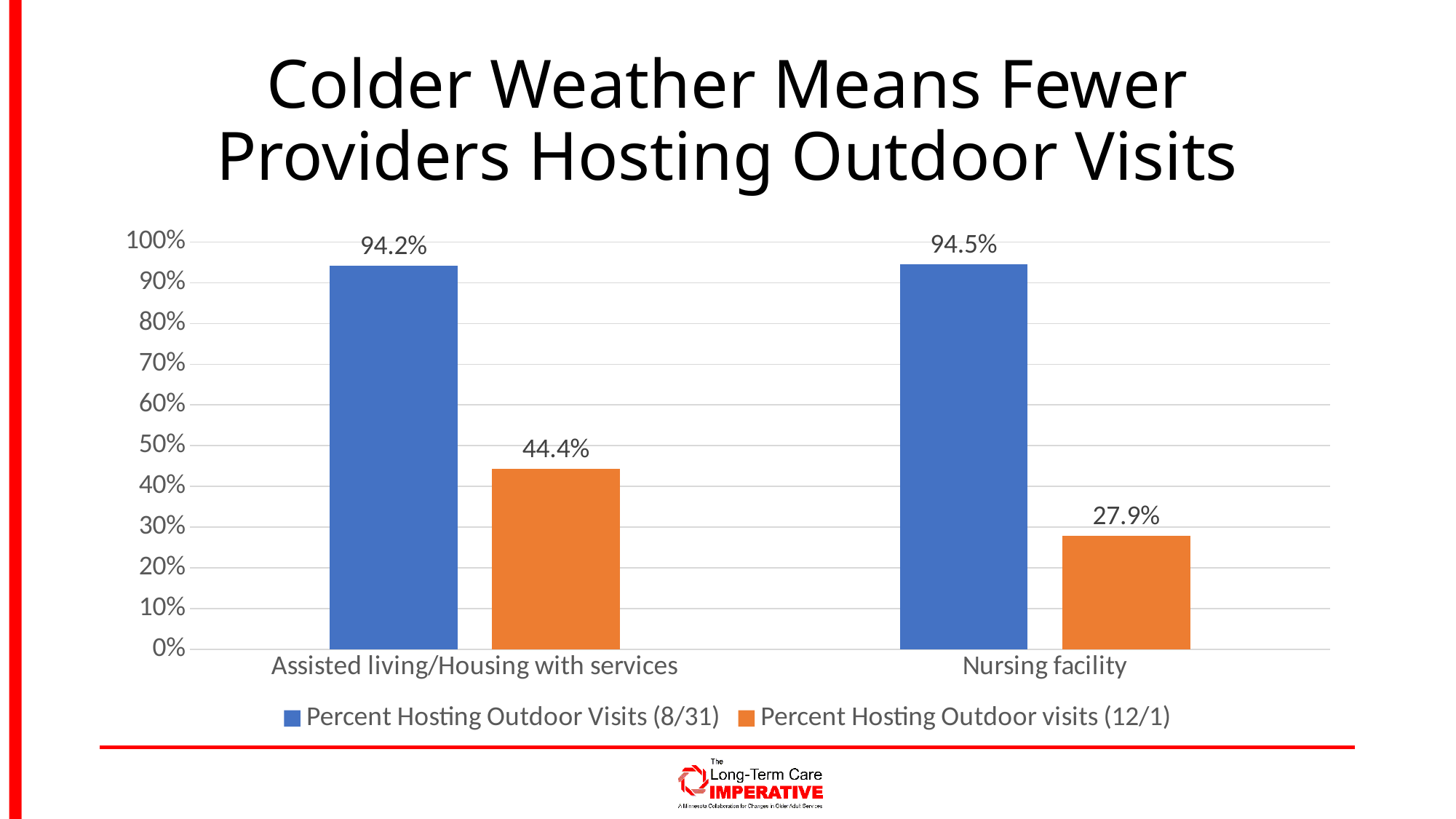
Which is larger: the 12/1 value for Assisted living/Housing with services or the 12/1 value for Nursing facility? Assisted living/Housing with services How many series does the legend list? 2 What is the difference between the 8/31 and 12/1 values for Assisted living/Housing with services? 49.8% What percent of Nursing facility providers were hosting outdoor visits on 8/31? 94.5% Which category has the lowest value for Percent Hosting Outdoor visits (12/1)? Nursing facility What is the title of the slide? Colder Weather Means Fewer Providers Hosting Outdoor Visits What percent of Assisted living/Housing with services providers were hosting outdoor visits on 8/31? 94.2% What percent of Nursing facility providers were hosting outdoor visits on 12/1? 27.9% What percent of Assisted living/Housing with services providers were hosting outdoor visits on 12/1? 44.4% How many categories are shown on the x axis? 2 What kind of chart is shown on the slide? Bar chart What is the difference between the 8/31 and 12/1 values for Nursing facility? 66.6%